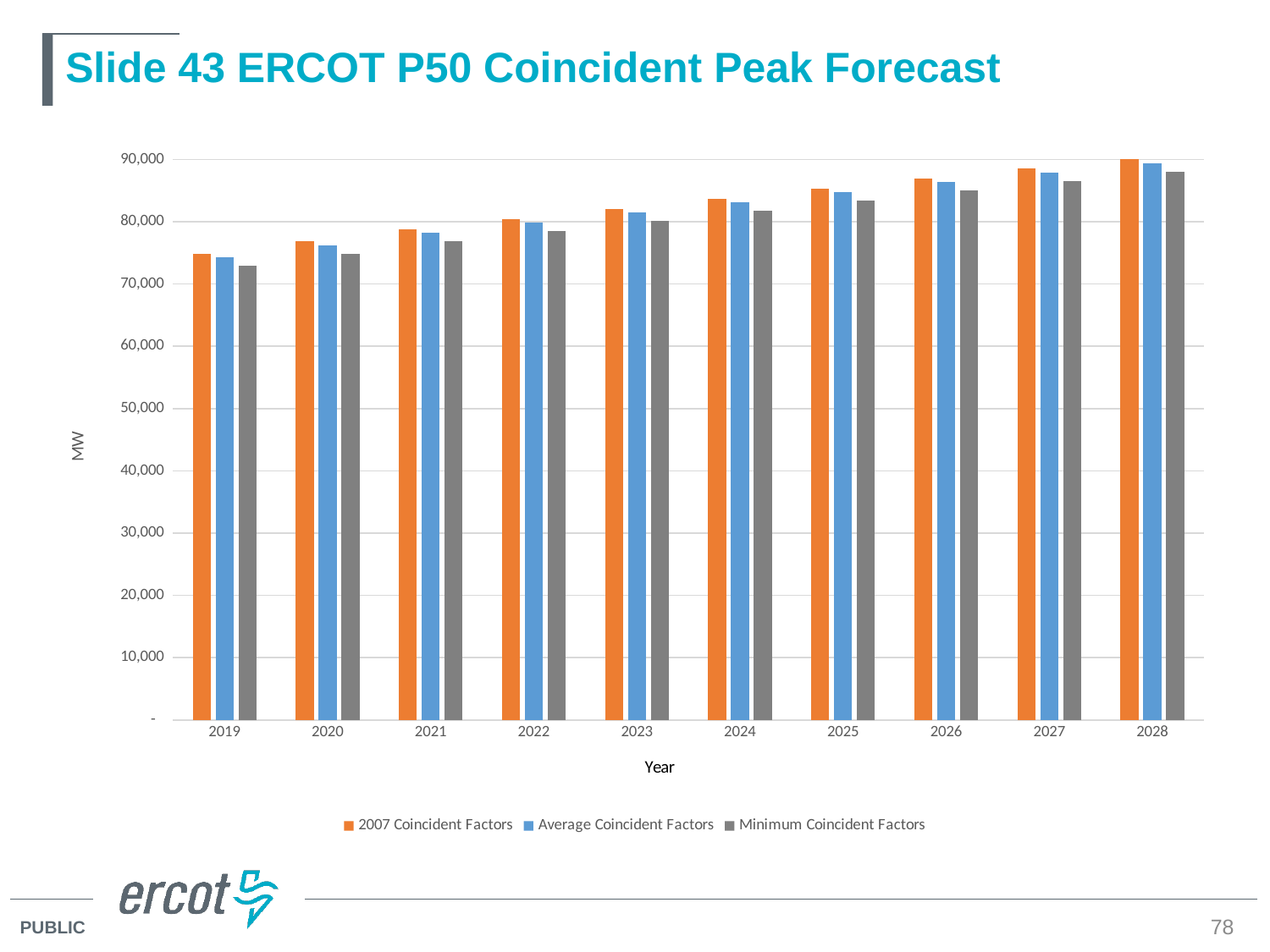
Is the value for Minimum Coincident Factors in 2019 greater or less than 80,000? less What kind of chart is shown on the slide? Bar chart Is the value for 2007 Coincident Factors in 2028 greater or less than 80,000? greater What colour represents Average Coincident Factors in the legend? Blue How many series does the legend list? 3 In 2019, which is larger: 2007 Coincident Factors or Minimum Coincident Factors? 2007 Coincident Factors Which year has the highest value for 2007 Coincident Factors? 2028 Is the value for 2007 Coincident Factors in 2019 greater or less than 70,000? greater Do the 2007 Coincident Factors values rise or fall from 2019 to 2028? Rise What is the label on the y axis? MW Which year has the lowest value for Minimum Coincident Factors? 2019 How many years are shown on the x axis? 10